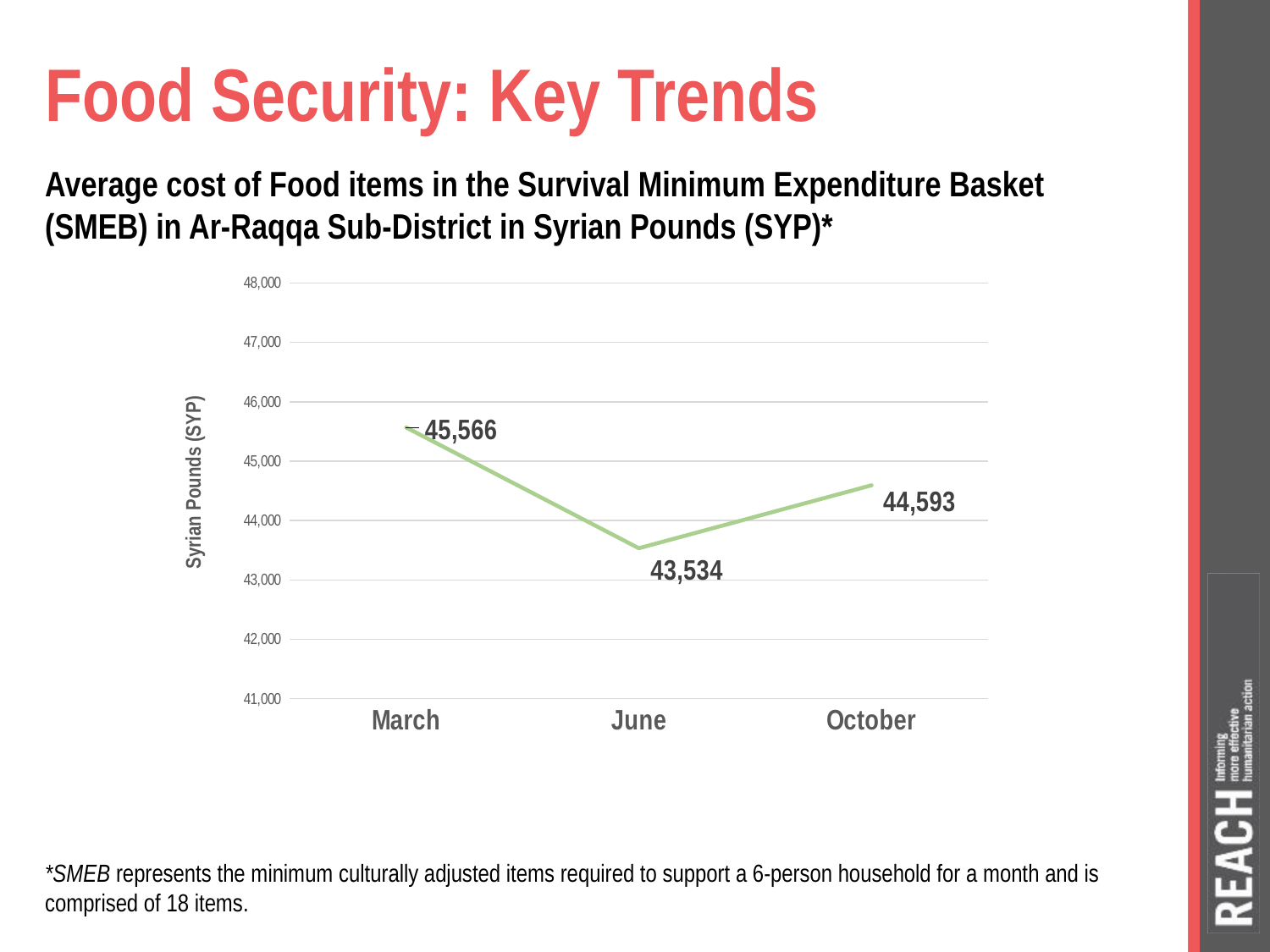
What is the label of the vertical axis? Syrian Pounds (SYP) Which month has the highest average cost of food items in the SMEB? March How many months are plotted on the chart? 3 Which is larger, the value for March or the value for October? March What is the average cost of food items in the SMEB in June? 43,534 Which month has the lowest average cost of food items in the SMEB? June What is the difference between the October and June values? 1,059 What is the difference between the March and June values? 2,032 What is the average cost of food items in the SMEB in March? 45,566 What is the average cost of food items in the SMEB in October? 44,593 Is the value for June greater or less than 44,000? less What kind of chart is shown on the slide? line chart